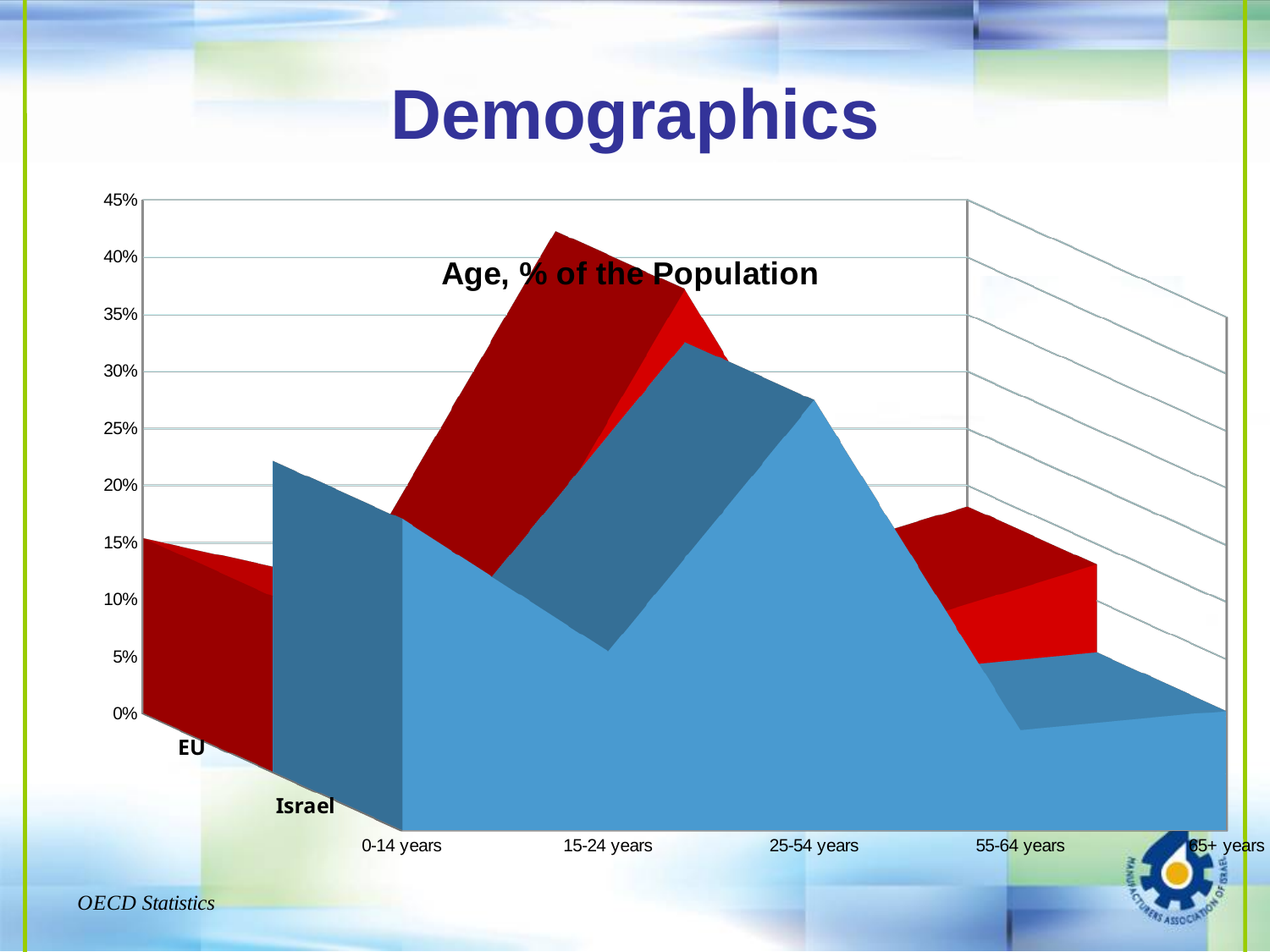
For Israel, which age group has the highest share of the population? 25-54 years In the 65+ years group, which series has the larger value, EU or Israel? EU In the 0-14 years group, which series has the larger value, EU or Israel? Israel How many series does the chart show? 2 What kind of chart is shown on the slide? Area chart Is the value for Israel in the 55-64 years group greater or less than 15%? less How many age categories are shown on the x axis? 5 Which series is drawn in red? EU What is the title of the chart? Age, % of the Population Do the values for Israel rise or fall from 25-54 years to 65+ years? fall Is the value for EU in the 0-14 years group greater or less than 25%? less Is the value for Israel in the 25-54 years group greater or less than 20%? greater